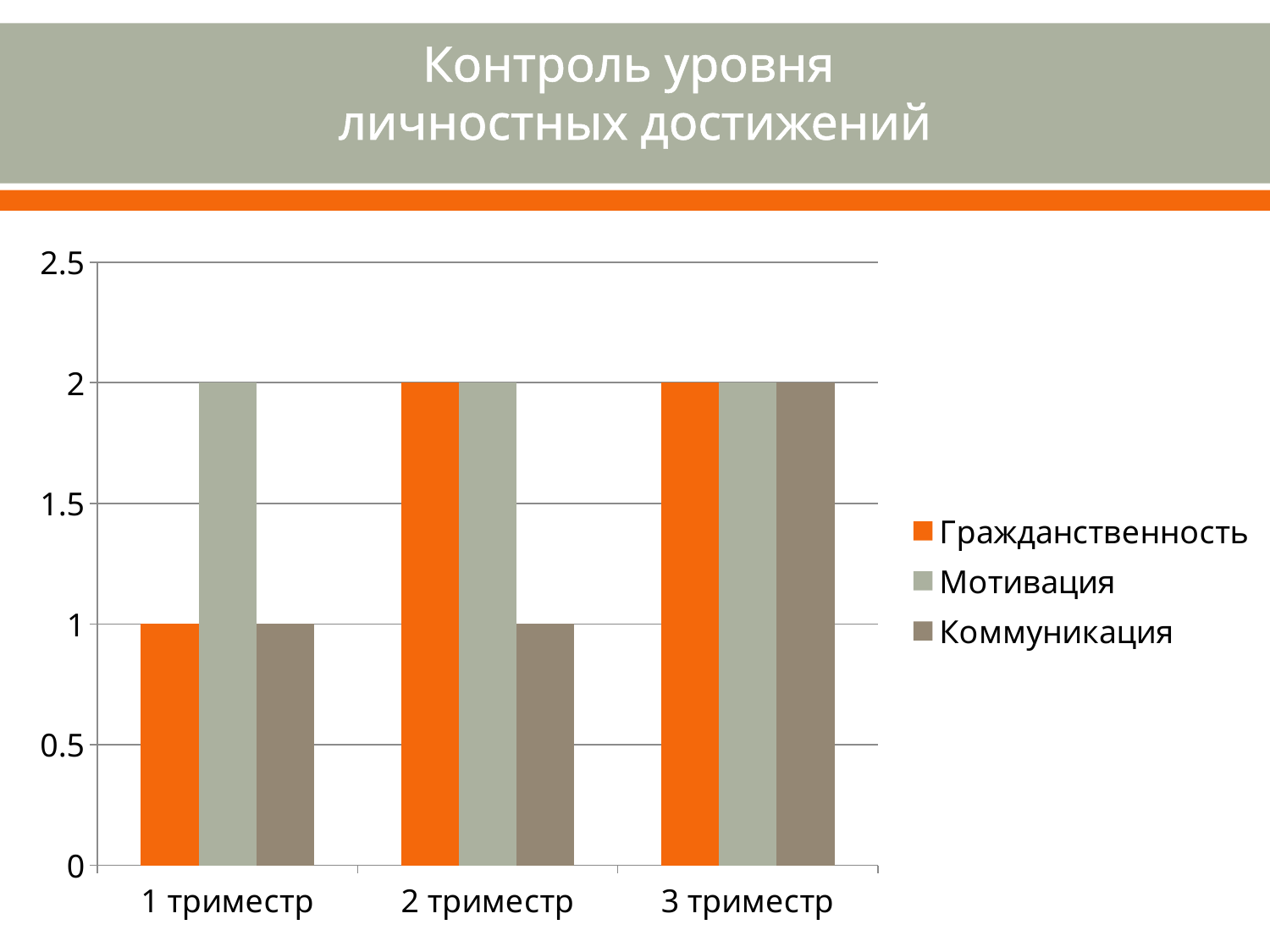
Which series has the lowest value in 2 триместр? Коммуникация What is the value for Мотивация in 1 триместр? 2 What is the value for Коммуникация in 2 триместр? 1 What is the value for Коммуникация in 3 триместр? 2 How many categories are shown on the x axis? 3 Does the value for Гражданственность rise or fall from 1 триместр to 2 триместр? rise What is the title of the slide? Контроль уровня личностных достижений Which series has the highest value in 1 триместр? Мотивация How many series does the legend list? 3 What is the difference between Мотивация and Гражданственность in 1 триместр? 1 What is the value for Гражданственность in 1 триместр? 1 What type of chart is shown on the slide? bar chart